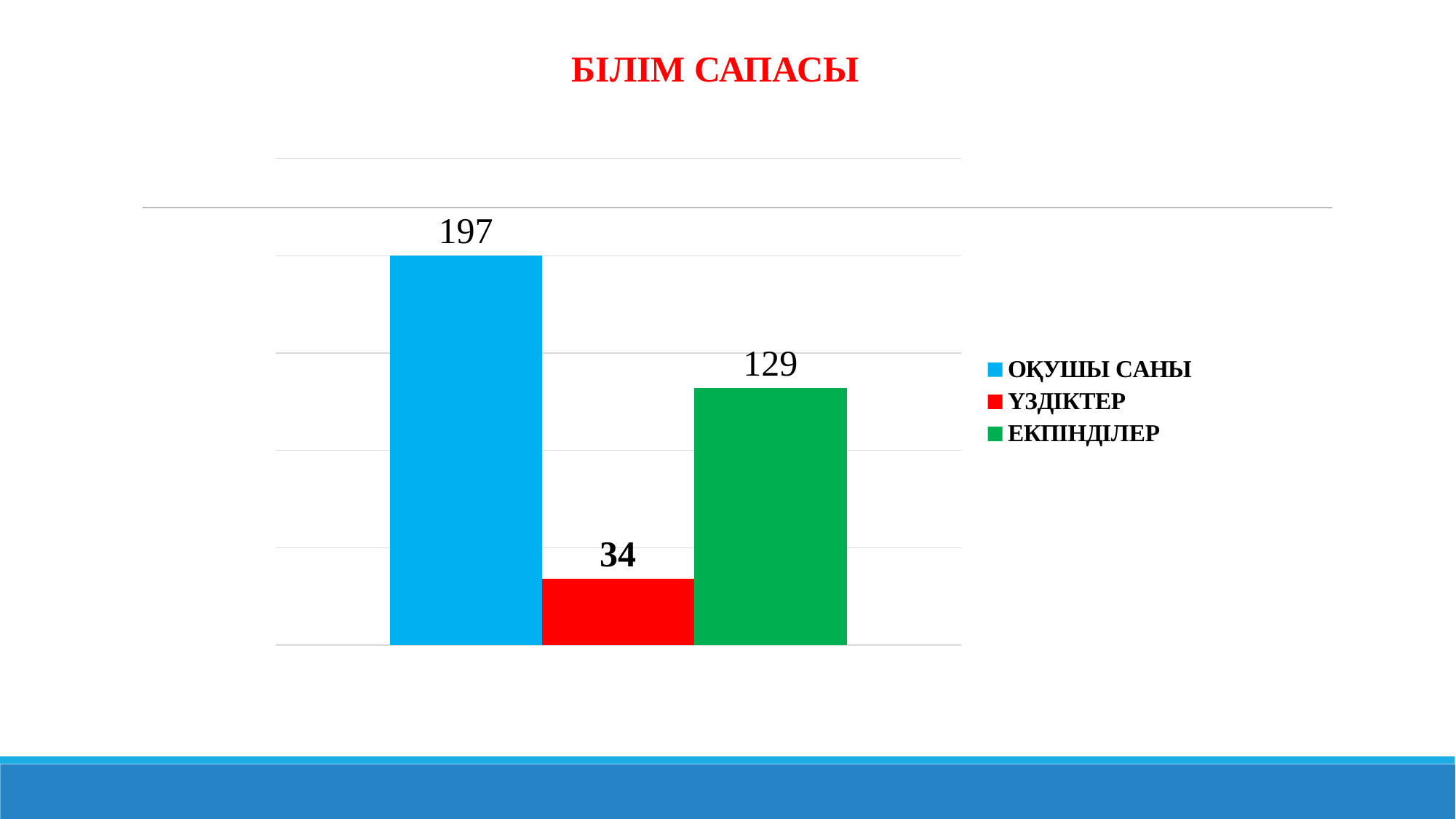
What is the difference between the values for ОҚУШЫ САНЫ and ЕКПІНДІЛЕР? 68 What is the value for ЕКПІНДІЛЕР? 129 What is the title of the slide? БІЛІМ САПАСЫ Which is larger, the value for ҮЗДІКТЕР or the value for ЕКПІНДІЛЕР? ЕКПІНДІЛЕР Which series has the highest value? ОҚУШЫ САНЫ How many bars are plotted on the chart? 3 What is the value for ОҚУШЫ САНЫ? 197 How many series does the legend list? 3 What is the value for ҮЗДІКТЕР? 34 Which series has the lowest value? ҮЗДІКТЕР What kind of chart is shown on the slide? bar chart What is the difference between the values for ЕКПІНДІЛЕР and ҮЗДІКТЕР? 95